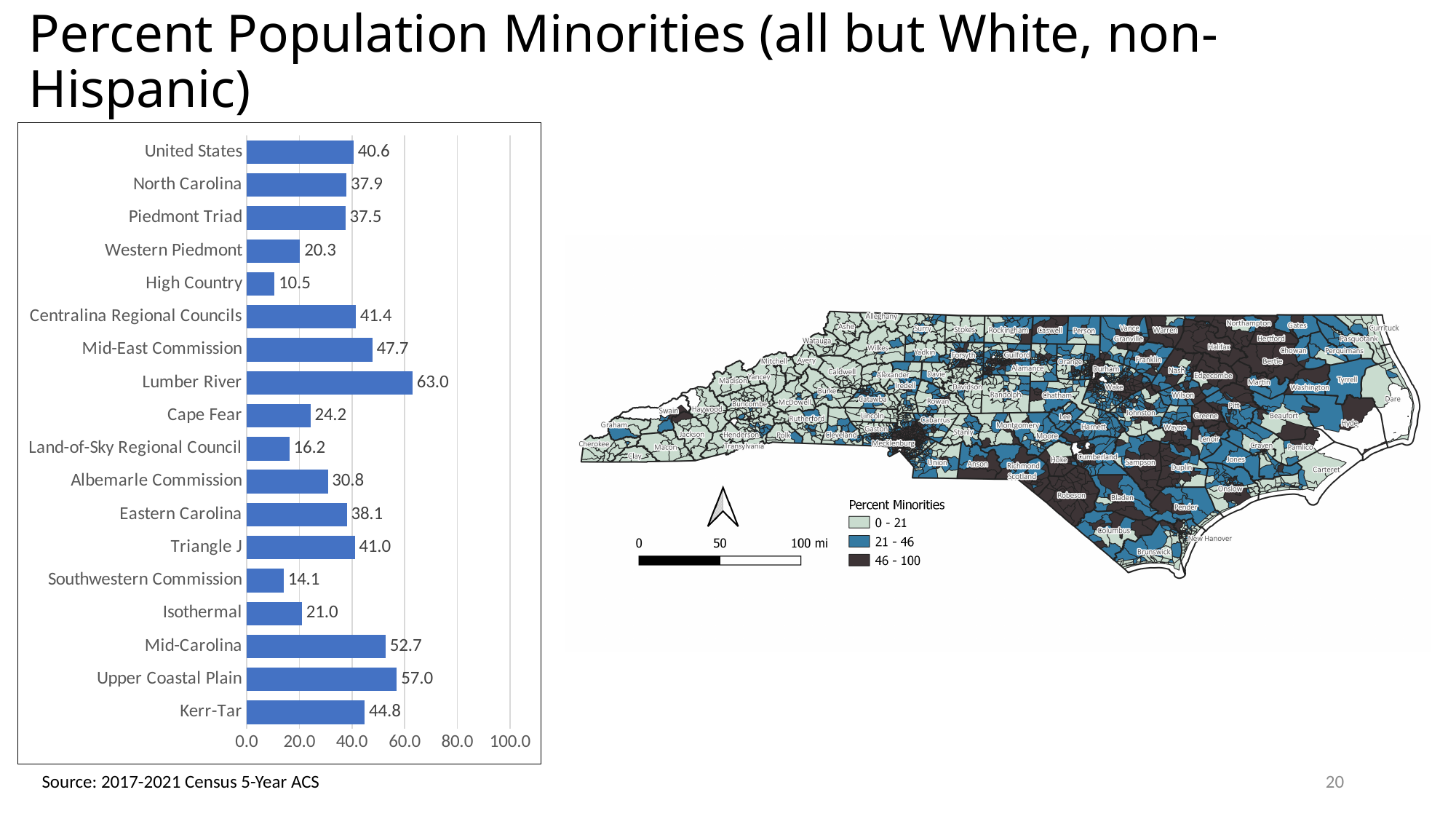
In the bar chart, which category has the highest value? Lumber River In the bar chart, what is the value for Southwestern Commission? 14.1 In the bar chart, what is the value for North Carolina? 37.9 In the bar chart, which category has the lowest value? High Country How many categories are shown in the bar chart? 18 In the bar chart, what is the value for Lumber River? 63.0 In the bar chart, is the value for Cape Fear greater or less than 40.0? less In the bar chart, which is larger, the value for Mid-East Commission or the value for Kerr-Tar? Mid-East Commission In the bar chart, what is the difference between the values for Upper Coastal Plain and Mid-Carolina? 4.3 What kind of chart is shown on the left of the slide? bar chart In the bar chart, what is the difference between the values for Lumber River and High Country? 52.5 How many classes does the map legend for Percent Minorities list? 3